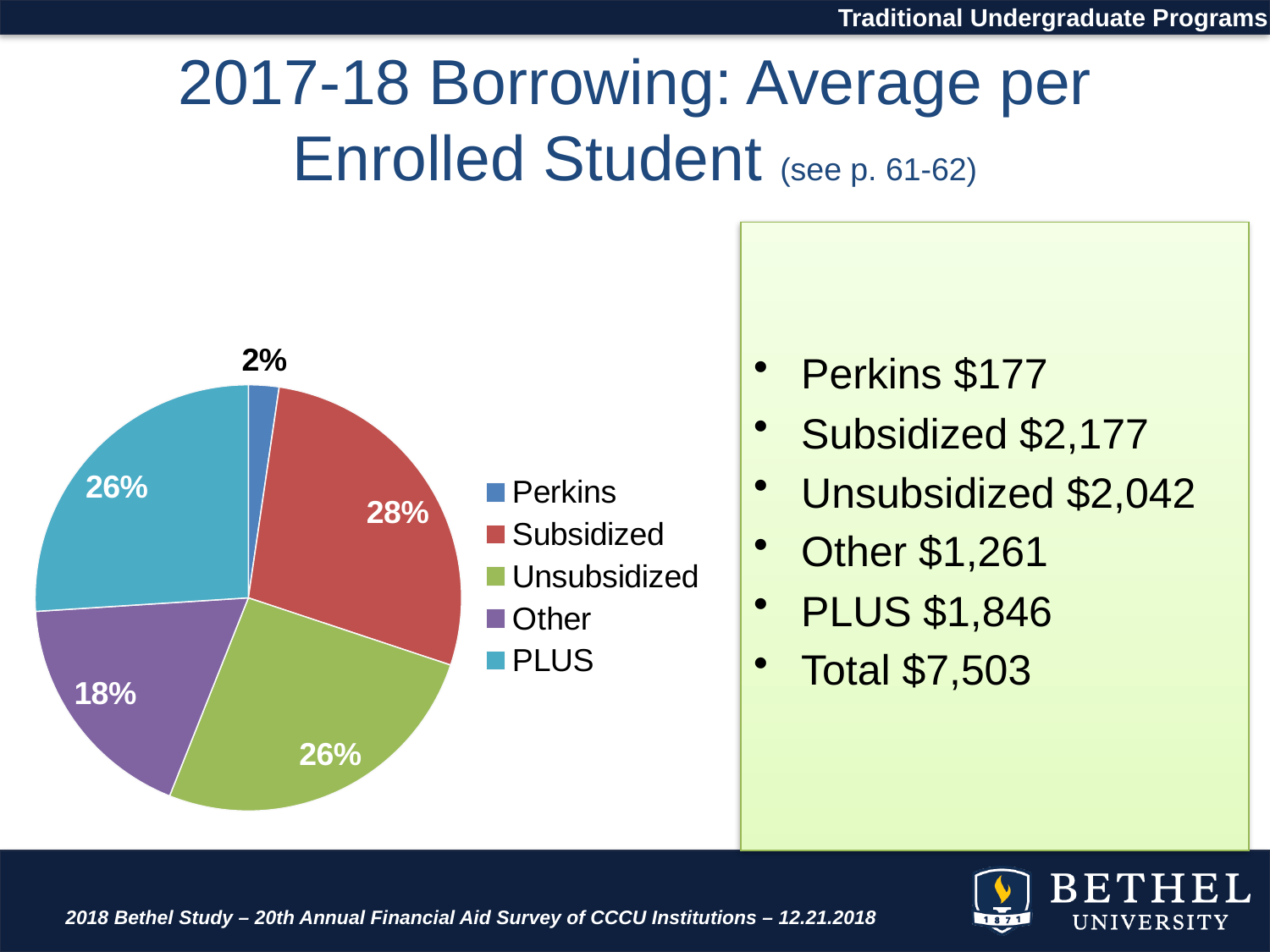
What percentage is shown for the PLUS slice? 26% What percentage is shown for the Unsubsidized slice? 26% Which category has the largest slice of the pie? Subsidized What share of the pie does Perkins represent? 2% What share of the pie does Other represent? 18% Which category is shown in red in the pie chart legend? Subsidized How many slices does the pie chart have? 5 What kind of chart is shown on the slide? pie chart Which category has the smallest slice of the pie? Perkins Which slice is larger, Subsidized or Other? Subsidized What share of the pie does Subsidized represent? 28% What is the difference in percentage points between the Subsidized slice and the Other slice? 10%